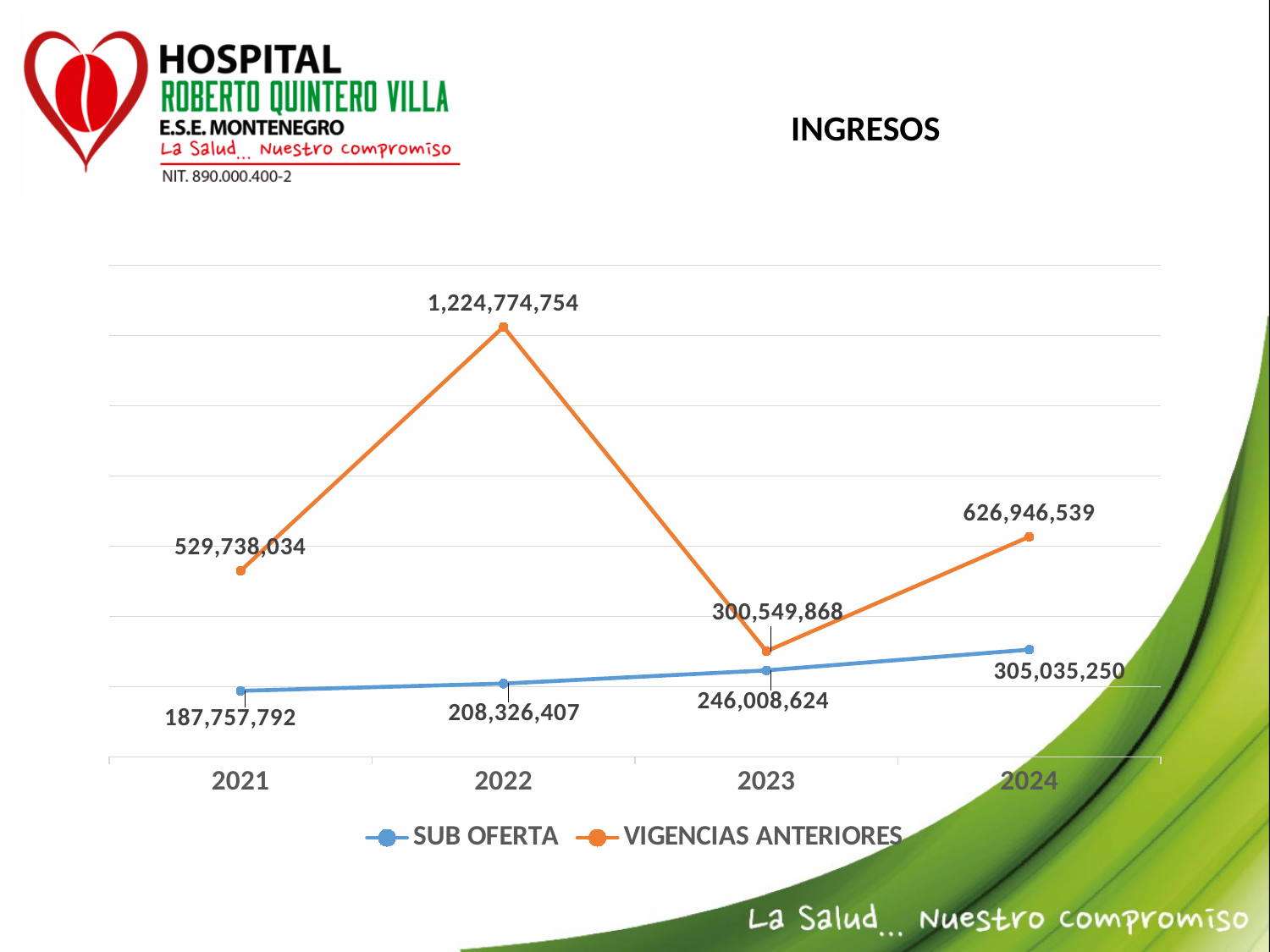
Does SUB OFERTA rise or fall from 2021 to 2024? rise How many series does the legend list? 2 What is the difference between VIGENCIAS ANTERIORES and SUB OFERTA in 2022? 1,016,448,347 In which year is VIGENCIAS ANTERIORES highest? 2022 By how much did SUB OFERTA increase from 2021 to 2024? 117,277,458 What is the value for VIGENCIAS ANTERIORES in 2023? 300,549,868 What is the value for VIGENCIAS ANTERIORES in 2022? 1,224,774,754 Which series has the larger value in 2024, SUB OFERTA or VIGENCIAS ANTERIORES? VIGENCIAS ANTERIORES In which year is SUB OFERTA lowest? 2021 In which year is VIGENCIAS ANTERIORES lowest? 2023 What is the value for SUB OFERTA in 2024? 305,035,250 What is the value for SUB OFERTA in 2021? 187,757,792